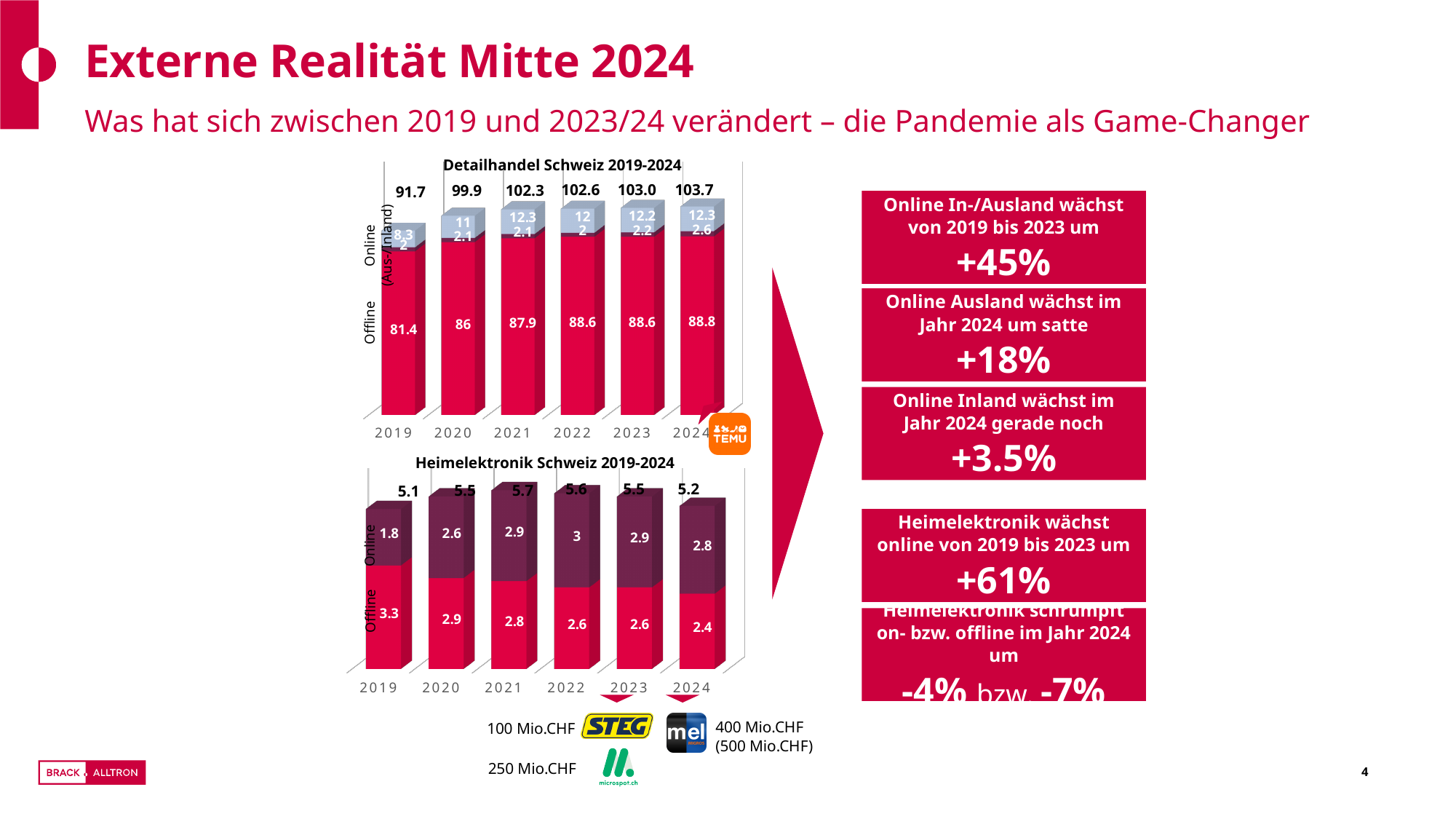
What kind of chart is 'Heimelektronik Schweiz 2019-2024'? stacked bar chart In the 'Heimelektronik Schweiz 2019-2024' chart, what is the Online value for 2022? 3 In the 'Heimelektronik Schweiz 2019-2024' chart, what is the Offline value for 2024? 2.4 In the 'Heimelektronik Schweiz 2019-2024' chart, is the Offline value larger in 2019 or in 2023? 2019 In the 'Detailhandel Schweiz 2019-2024' chart, which year has the lowest total? 2019 In the 'Heimelektronik Schweiz 2019-2024' chart, what is the difference between the Online values for 2021 and 2019? 1.1 In the 'Heimelektronik Schweiz 2019-2024' chart, which year has the highest total? 2021 In the 'Detailhandel Schweiz 2019-2024' chart, how many years are shown on the x axis? 6 In the 'Heimelektronik Schweiz 2019-2024' chart, do the Offline values rise or fall from 2019 to 2024? fall In the 'Detailhandel Schweiz 2019-2024' chart, what is the difference between the Offline values for 2024 and 2019? 7.4 In the 'Detailhandel Schweiz 2019-2024' chart, what is the Offline value for 2019? 81.4 In the 'Detailhandel Schweiz 2019-2024' chart, what is the total shown above the 2024 bar? 103.7